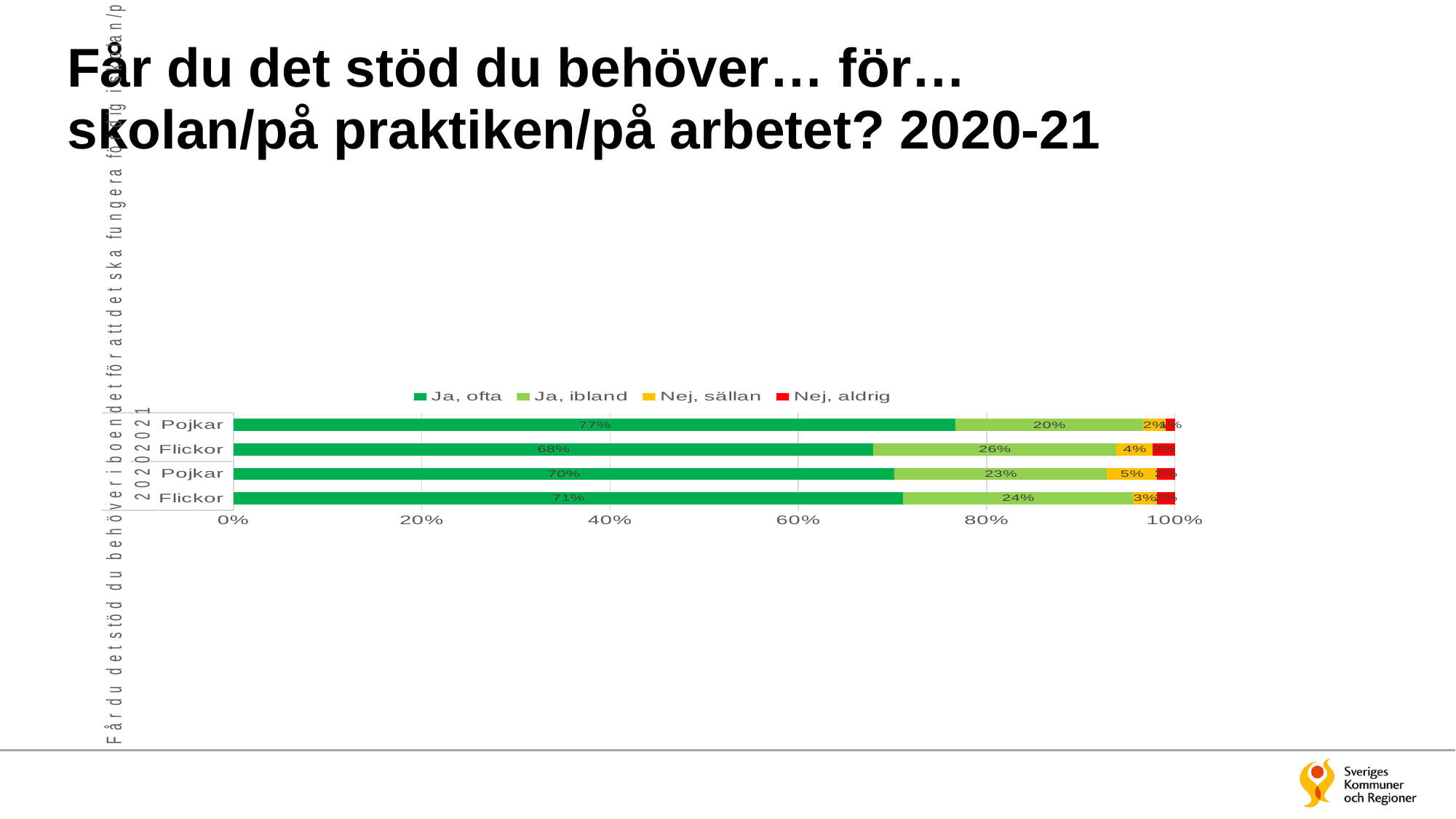
How many bars are plotted in the chart? 4 Which legend entry is shown in red? Nej, aldrig What is the 'Ja, ofta' value for Flickor in 2021? 68% How many series does the legend list? 4 What is the 'Ja, ofta' value for Pojkar in 2021? 77% Which bar has the lowest 'Ja, ofta' value? Flickor 2021 Which is larger, the 'Ja, ibland' value for Flickor 2021 or for Flickor 2020? Flickor 2021 Which bar has the highest 'Ja, ofta' value? Pojkar 2021 What is the 'Nej, sällan' value for Flickor in 2021? 4% What kind of chart is shown on the slide? stacked bar chart What is the 'Ja, ibland' value for Pojkar in 2020? 23% What is the difference between the 'Ja, ofta' values for Pojkar 2021 and Flickor 2021? 9 percentage points